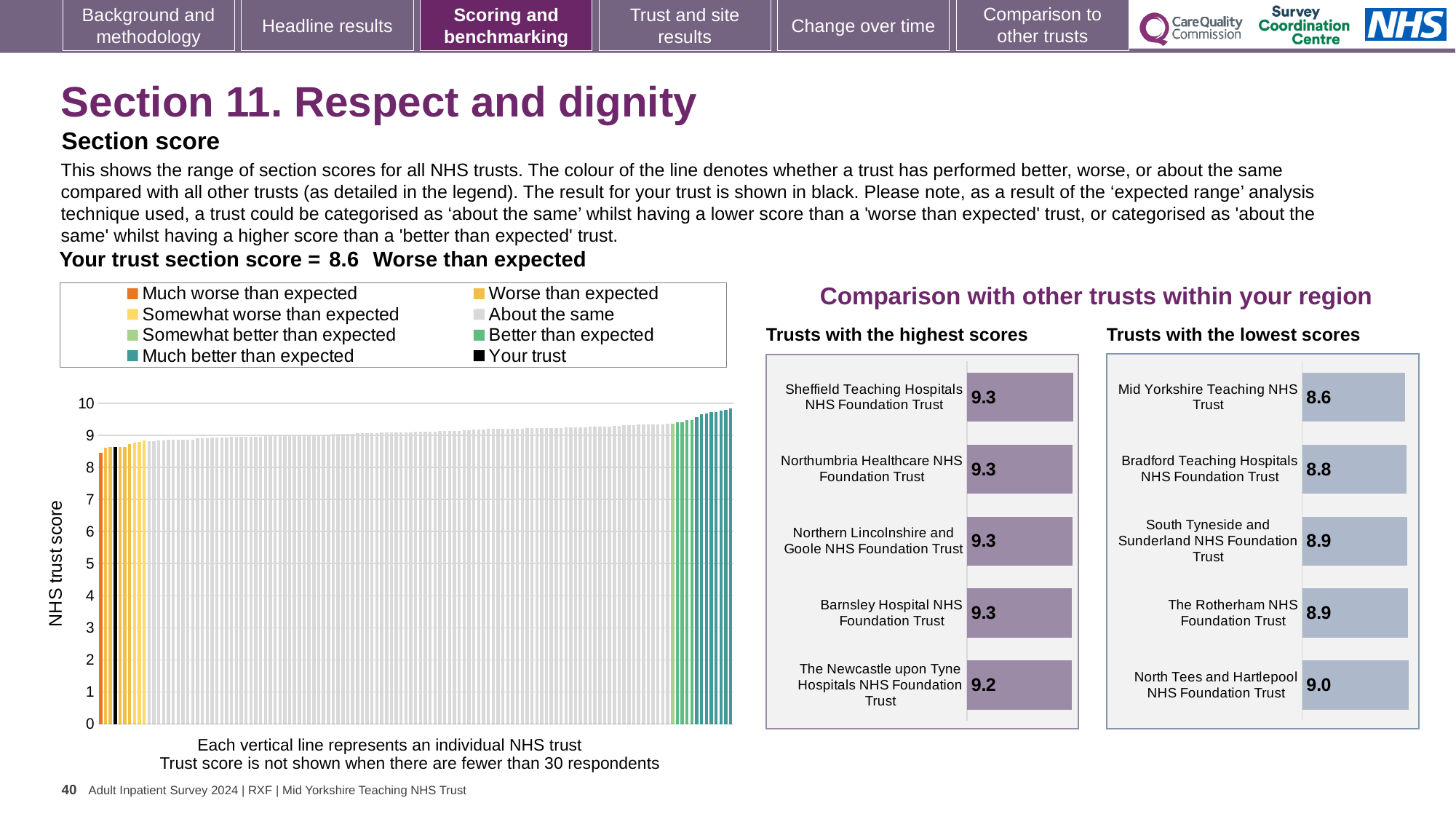
How many trusts are shown in the 'Trusts with the highest scores' chart? 5 In the 'Trusts with the highest scores' chart, which trust has the lowest score? The Newcastle upon Tyne Hospitals NHS Foundation Trust In the 'Trusts with the lowest scores' chart, which trust has the lowest score? Mid Yorkshire Teaching NHS Trust What kind of chart is the 'NHS trust score' chart on the left of the slide? bar chart In the 'Trusts with the highest scores' chart, what is the score for Sheffield Teaching Hospitals NHS Foundation Trust? 9.3 In the 'Trusts with the lowest scores' chart, which has the higher score: Bradford Teaching Hospitals NHS Foundation Trust or The Rotherham NHS Foundation Trust? The Rotherham NHS Foundation Trust In the 'Trusts with the lowest scores' chart, what is the difference between the scores of Bradford Teaching Hospitals NHS Foundation Trust and Mid Yorkshire Teaching NHS Trust? 0.2 How many entries does the legend of the 'NHS trust score' chart on the left list? 8 In the 'Trusts with the lowest scores' chart, what is the score for Mid Yorkshire Teaching NHS Trust? 8.6 In the 'Trusts with the lowest scores' chart, what is the score for North Tees and Hartlepool NHS Foundation Trust? 9.0 In the 'Trusts with the lowest scores' chart, which trust has the highest score? North Tees and Hartlepool NHS Foundation Trust In the 'Trusts with the highest scores' chart, what is the score for The Newcastle upon Tyne Hospitals NHS Foundation Trust? 9.2